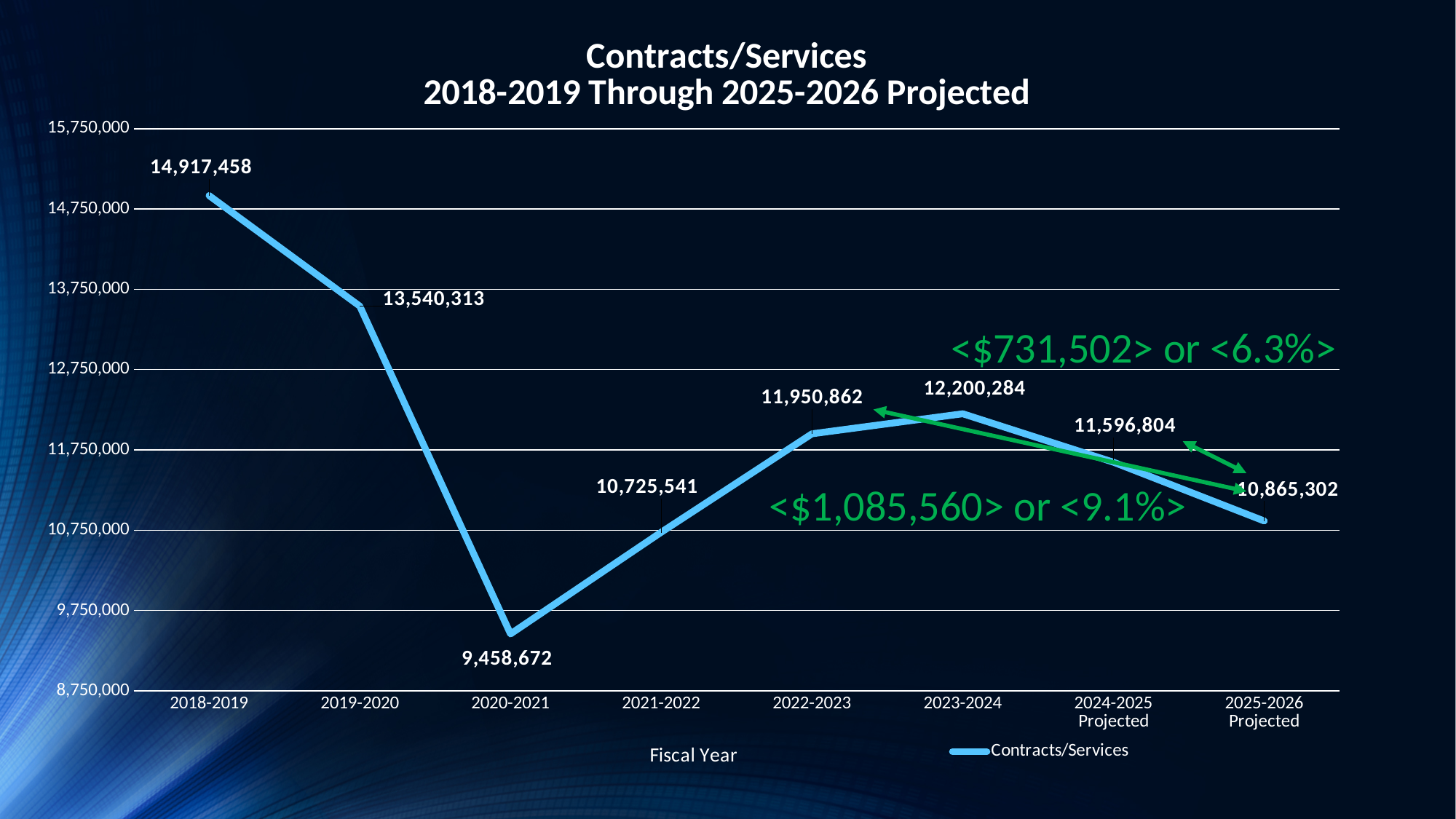
Do the values rise or fall from 2020-2021 to 2023-2024? rise How many fiscal years are plotted on the chart? 8 Which fiscal year has the lowest Contracts/Services value? 2020-2021 What is the Contracts/Services value for 2020-2021? 9,458,672 How many series does the legend list? 1 What is the difference between the 2023-2024 value and the 2024-2025 Projected value? 603,480 Which fiscal year has the highest Contracts/Services value? 2018-2019 What is the projected Contracts/Services value for 2025-2026? 10,865,302 Which is larger, the value for 2021-2022 or the value for 2022-2023? 2022-2023 What is the Contracts/Services value for 2018-2019? 14,917,458 What kind of chart is shown on the slide? line chart Is the value for 2019-2020 greater or less than 13,750,000? less